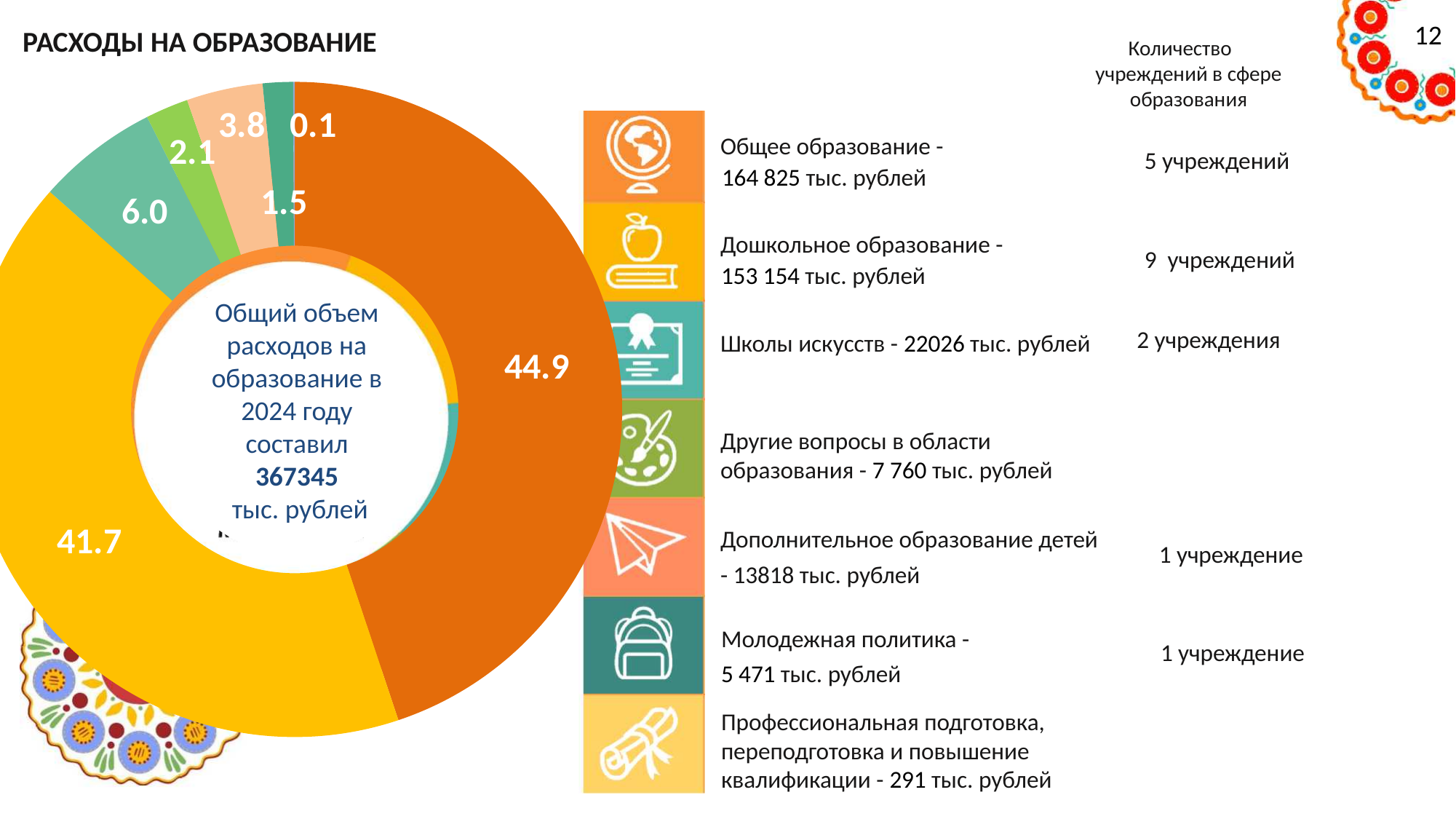
What is the title of the slide with the chart? РАСХОДЫ НА ОБРАЗОВАНИЕ What value is labelled on the teal slice of the pie chart, between the yellow and green slices? 6.0 What is the difference between the two largest slice values, 44.9 and 41.7? 3.2 What is the largest value labelled on the pie chart? 44.9 How many slices does the pie chart have? 7 Which is larger: the slice labelled 6.0 or the slice labelled 3.8? 6.0 What total volume of education expenditure in 2024 is stated in the centre of the doughnut chart? 367345 тыс. рублей What kind of chart is shown on the slide? pie chart (doughnut) What value is labelled on the large orange slice of the pie chart? 44.9 What is the smallest value labelled on the pie chart? 0.1 What is the combined value of the two largest slices, 44.9 and 41.7? 86.6 What value is labelled on the yellow slice of the pie chart? 41.7